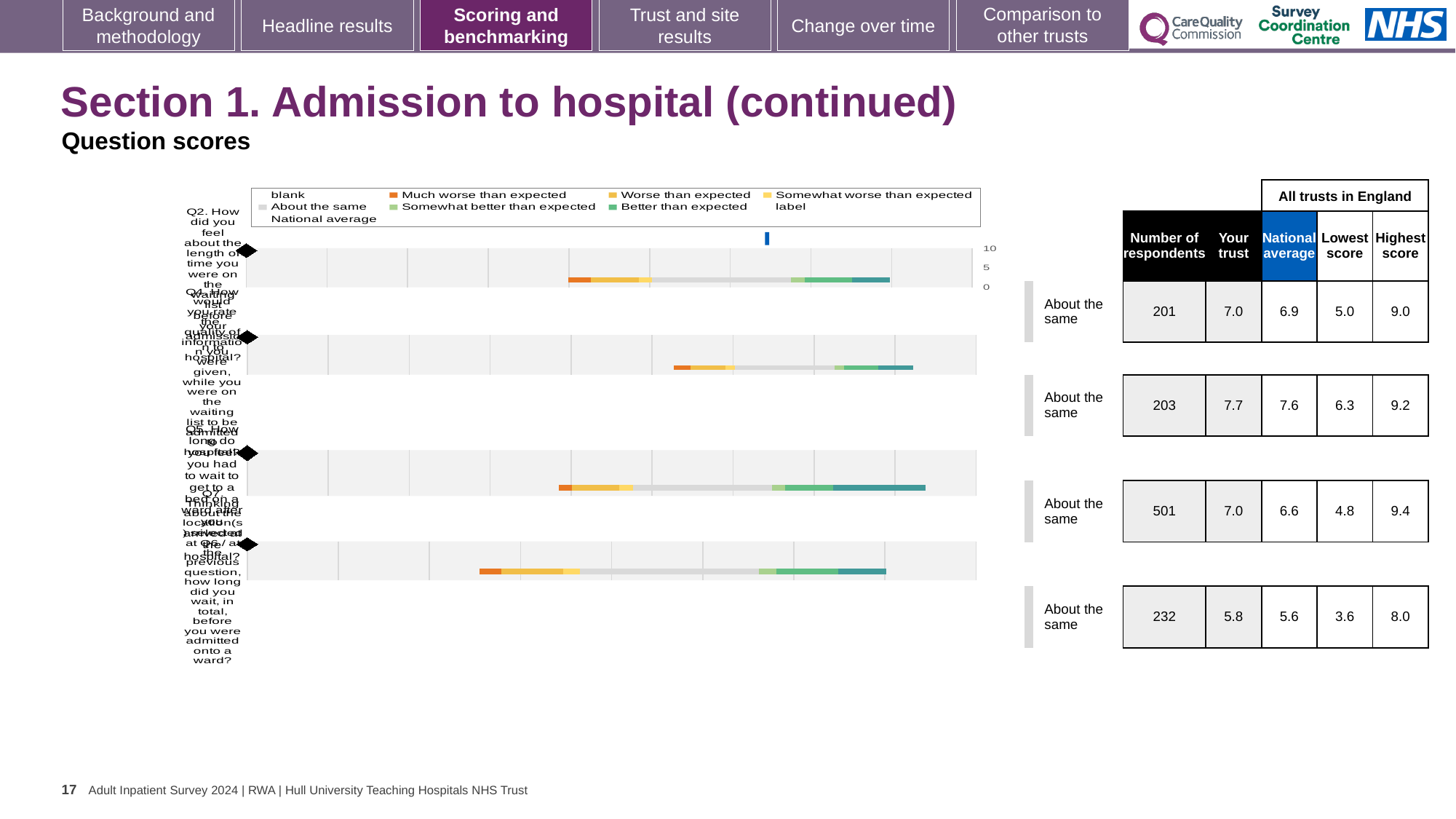
How many horizontal bars are plotted in the chart? 4 What benchmark label is shown next to the first bar? About the same In the table, which row has the highest number of respondents? the third row (501) In the table, what is the highest score in the third row? 9.4 In the table, which row has the lowest 'Your trust' score? the fourth row (5.8) In the table's second row, which is larger: the 'Your trust' score or the national average? Your trust (7.7) In the table, what is the national average in the fourth row? 5.6 What is the maximum value shown on the chart's axis? 10 What kind of chart is shown on the slide? bar chart In the table, what is the 'Your trust' score in the first row? 7.0 Which legend entry is shown in orange? Much worse than expected In the table, what is the difference between the highest score and the lowest score in the first row? 4.0